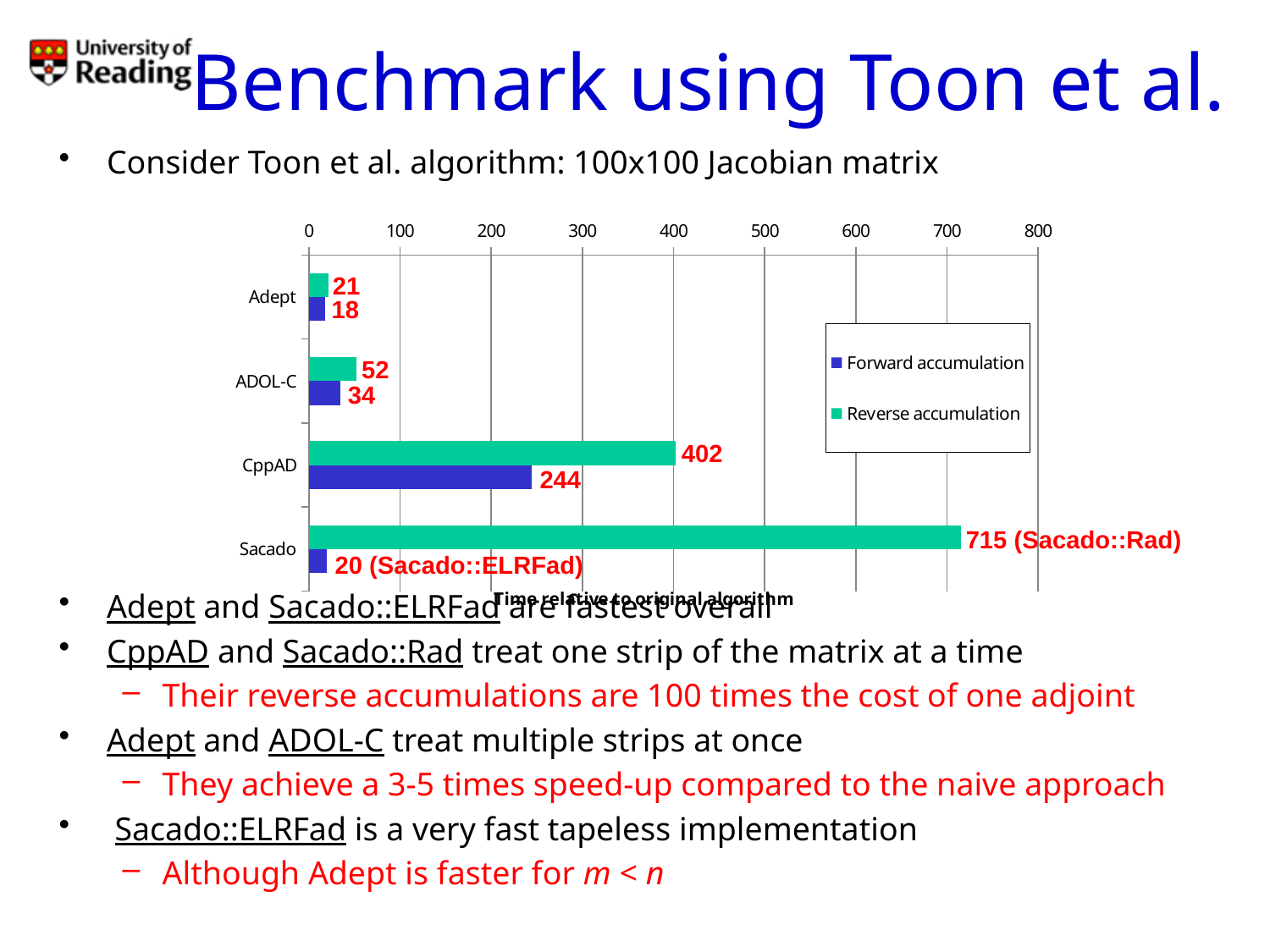
What kind of chart is shown on the slide? Bar chart Is the Reverse accumulation value for Sacado greater or less than 700? greater Which category has the highest Reverse accumulation value? Sacado Which is larger for ADOL-C: Forward accumulation or Reverse accumulation? Reverse accumulation What is the Reverse accumulation value for Adept? 21 How many categories are shown on the chart? 4 Which category has the lowest Forward accumulation value? Adept What is the Forward accumulation value for Sacado? 20 What is the Reverse accumulation value for CppAD? 402 What is the difference between the Reverse and Forward accumulation values for CppAD? 158 How many series does the legend list? 2 What is the Forward accumulation value for ADOL-C? 34